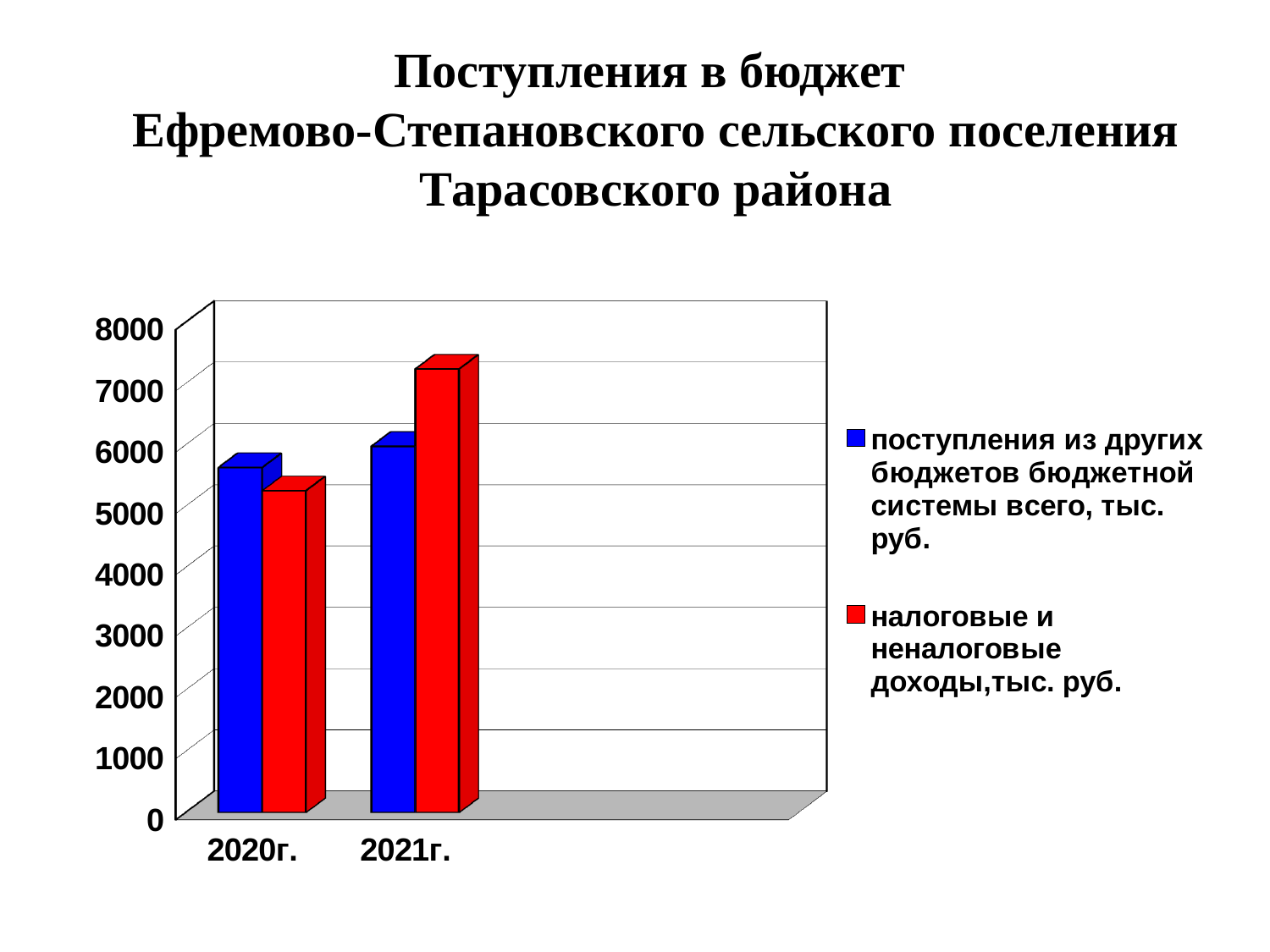
What kind of chart is shown on the slide? bar chart Is the value for 'налоговые и неналоговые доходы' in 2021г. greater or less than 8000? less How many year categories are shown on the x axis? 2 In 2020г., which is larger: 'поступления из других бюджетов бюджетной системы всего' or 'налоговые и неналоговые доходы'? поступления из других бюджетов бюджетной системы всего Which bar is the highest on the chart? налоговые и неналоговые доходы in 2021г. Which bar is the lowest on the chart? налоговые и неналоговые доходы in 2020г. Which years are shown on the x axis? 2020г. and 2021г. Is the value for 'поступления из других бюджетов бюджетной системы всего' in 2020г. greater or less than 5000? greater How many series does the legend list? 2 Do 'налоговые и неналоговые доходы' rise or fall from 2020г. to 2021г.? rise Which colour represents 'налоговые и неналоговые доходы, тыс. руб.'? red In 2021г., which is larger: 'поступления из других бюджетов бюджетной системы всего' or 'налоговые и неналоговые доходы'? налоговые и неналоговые доходы